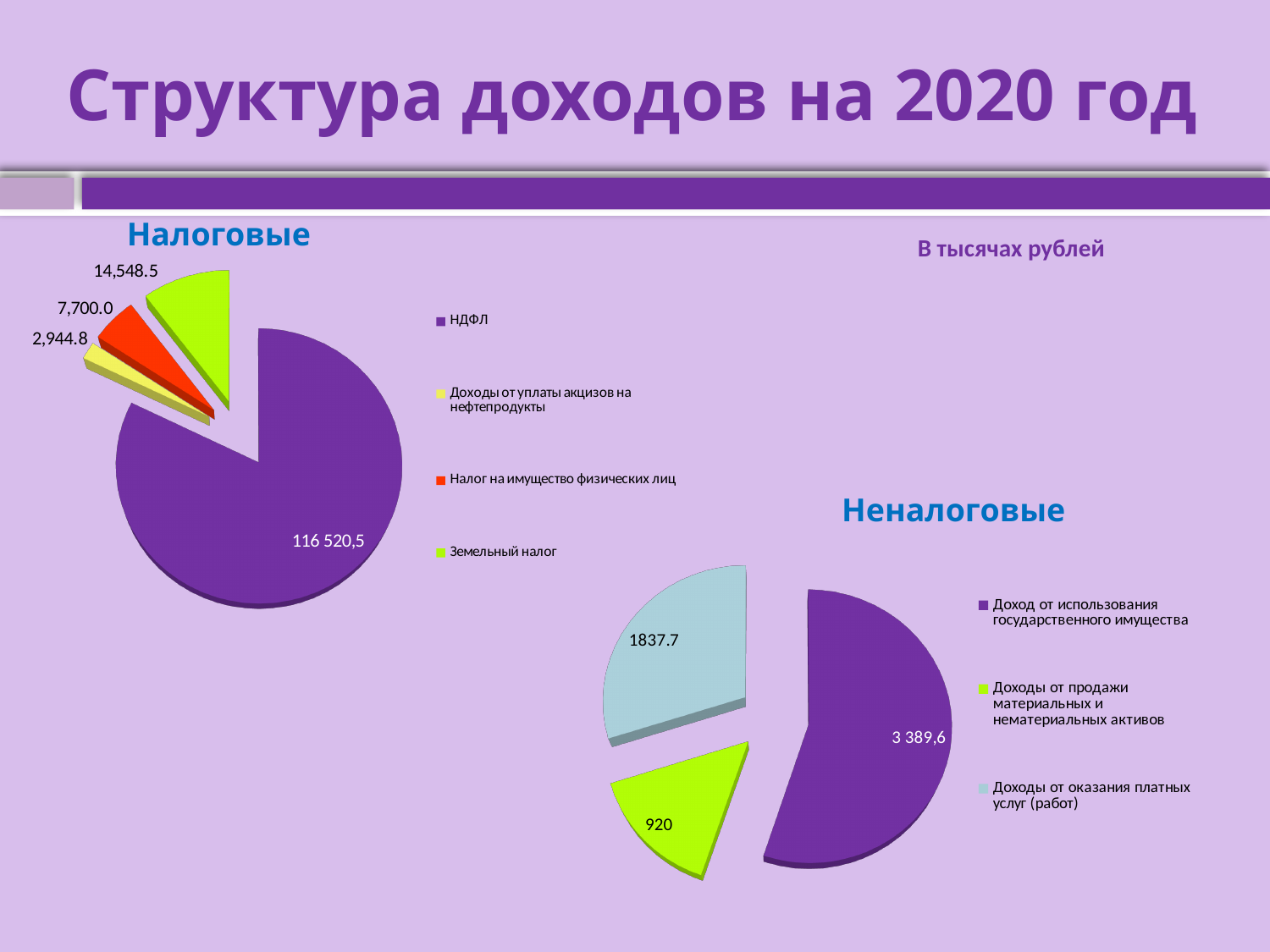
In the "Неналоговые" pie chart, what is the value for Доходы от продажи материальных и нематериальных активов? 920 In the "Налоговые" pie chart, what is the value for Земельный налог? 14,548.5 In the "Налоговые" pie chart, what is the value for НДФЛ? 116 520,5 What unit of measurement is stated on the slide for the chart values? В тысячах рублей In the "Налоговые" pie chart, what is the difference between Земельный налог and Налог на имущество физических лиц? 6,848.5 How many categories does the "Налоговые" pie chart show? 4 In the "Неналоговые" pie chart, what is the value for Доходы от оказания платных услуг (работ)? 1837.7 In the "Налоговые" pie chart, which category has the smallest value? Доходы от уплаты акцизов на нефтепродукты What type of chart is the "Неналоговые" chart? Pie chart In the "Неналоговые" pie chart, which is larger: Доходы от оказания платных услуг (работ) or Доходы от продажи материальных и нематериальных активов? Доходы от оказания платных услуг (работ) In the "Налоговые" pie chart, what is the value for Налог на имущество физических лиц? 7,700.0 In the "Неналоговые" pie chart, which category has the largest value? Доход от использования государственного имущества